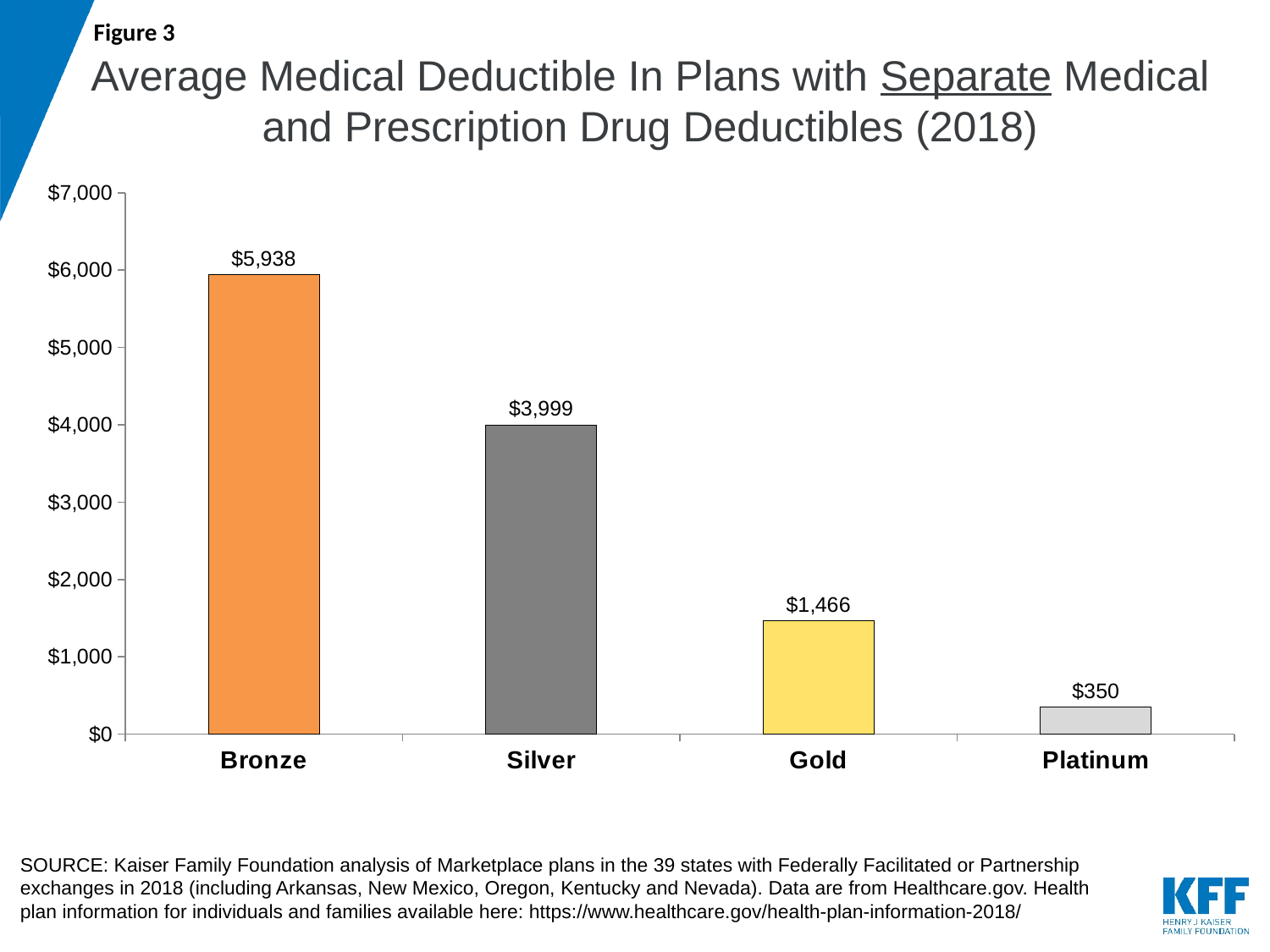
What is the average medical deductible for Bronze plans? $5,938 What is the difference between the Bronze and Silver average medical deductibles? $1,939 What is the average medical deductible for Silver plans? $3,999 Which plan tier has the highest average medical deductible? Bronze Which has a larger average medical deductible, Silver or Gold? Silver What is the average medical deductible for Gold plans? $1,466 What is the average medical deductible for Platinum plans? $350 How many plan tiers are shown in the chart? 4 What is the difference between the Gold and Platinum average medical deductibles? $1,116 Do the values rise or fall moving from Bronze to Platinum along the x axis? Fall What kind of chart is shown on the slide? Bar chart Which plan tier has the lowest average medical deductible? Platinum